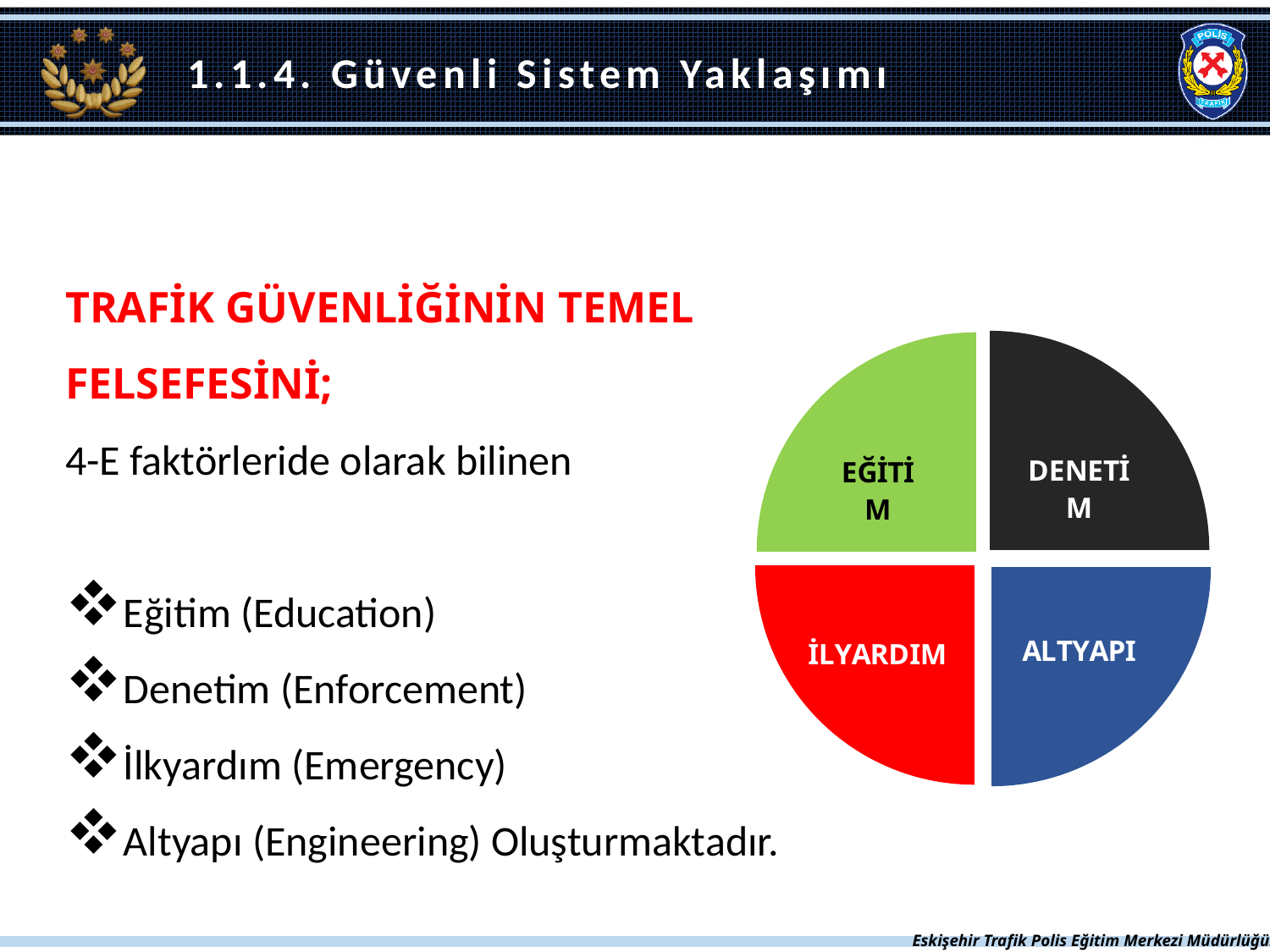
What colour is the ALTYAPI slice of the pie chart? blue Which slice of the pie chart is coloured red? İLYARDIM What kind of chart is shown on the slide? pie chart How many slices does the pie chart have? 4 Which slice of the pie chart is in the top-left quarter? EĞİTİM Which slice of the pie chart is in the top-right quarter? DENETİM